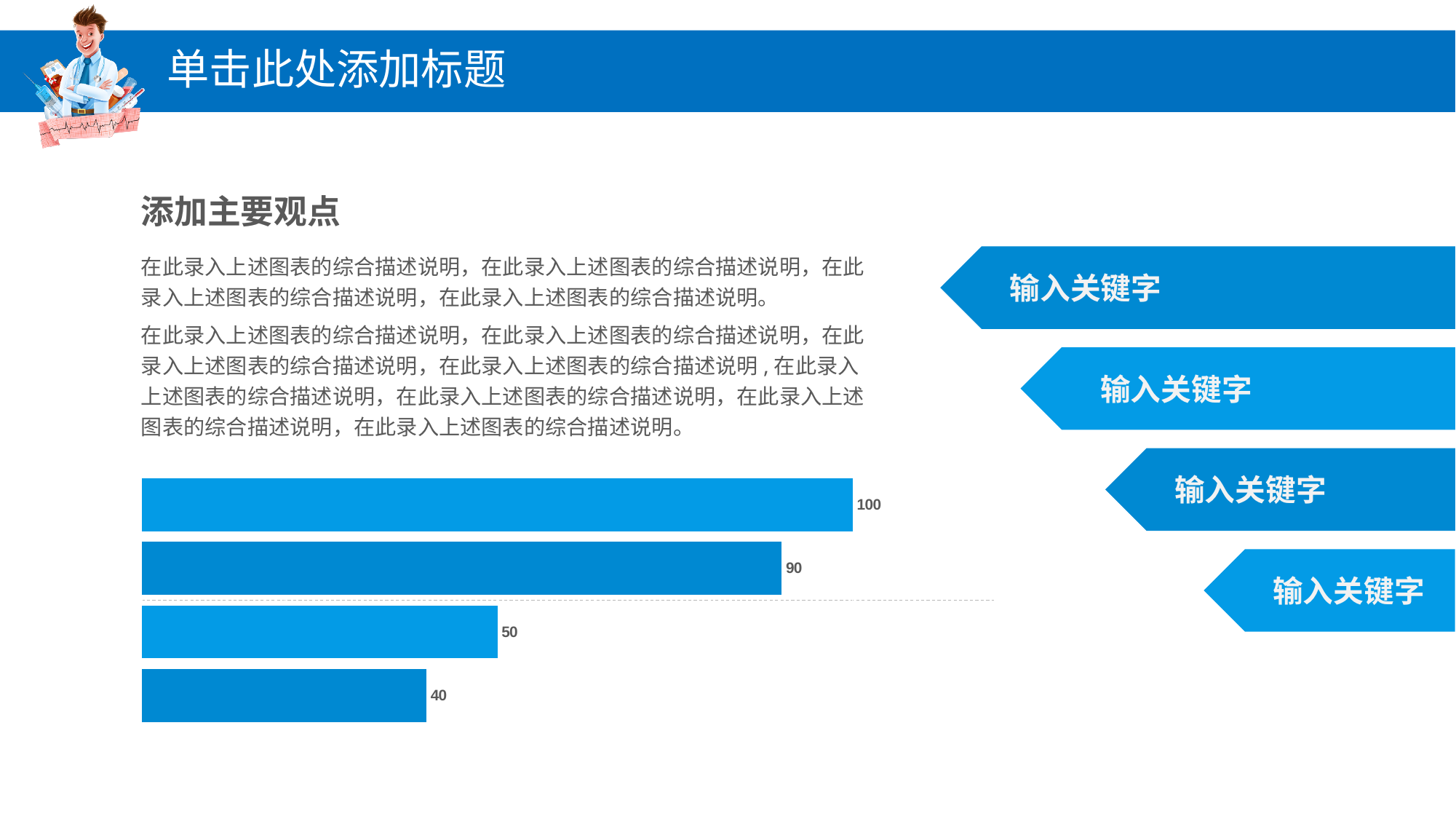
What is the difference between the top bar and the bottom bar in the chart? 60 Which is larger, the third bar from the top or the bottom bar? the third bar from the top (50) What kind of chart is shown on the slide? bar chart What is the value of the third bar from the top in the chart? 50 What is the value of the top bar in the chart? 100 What is the value of the bottom bar in the chart? 40 Which bar has the highest value in the chart? the top bar (100) Do the bar values increase or decrease from the top bar to the bottom bar? decrease What is the value of the second bar from the top in the chart? 90 What is the difference between the second bar (90) and the third bar (50) in the chart? 40 Which bar has the lowest value in the chart? the bottom bar (40) How many bars does the chart show? 4